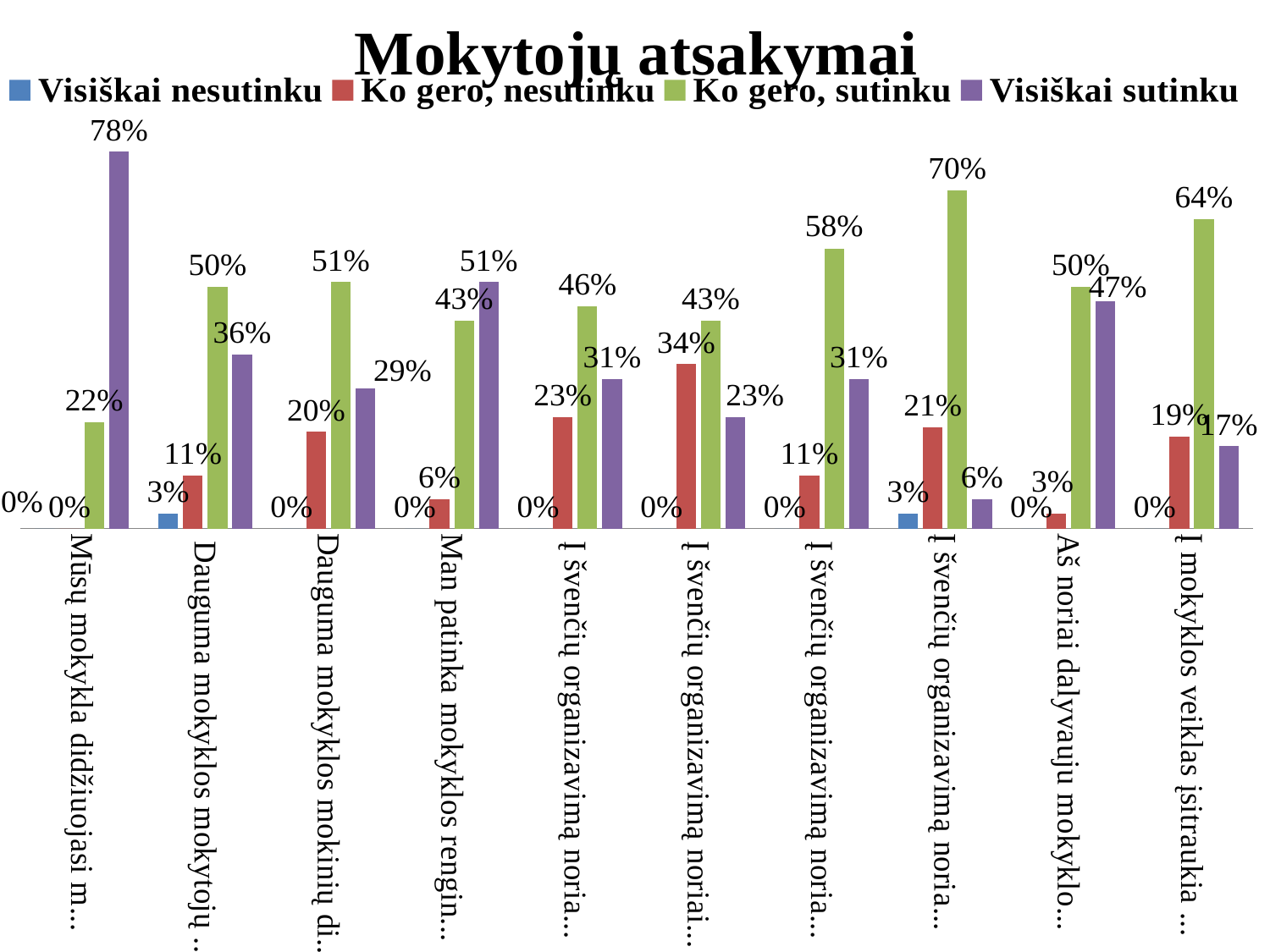
Which category has the highest 'Visiškai sutinku' value? Mūsų mokykla didžiuojasi m... What is the value of 'Ko gero, sutinku' for the category 'Į mokyklos veiklas įsitraukia ...'? 64% What is the title of the chart? Mokytojų atsakymai What is the value of 'Visiškai nesutinku' for the category 'Dauguma mokyklos mokytojų ...'? 3% How many series does the legend list? 4 What is the value of 'Ko gero, nesutinku' for the category 'Dauguma mokyklos mokinių di...'? 20% Which series is shown in green in the legend? Ko gero, sutinku What kind of chart is shown on the slide? bar chart How many categories are shown along the x axis? 10 For the category 'Man patinka mokyklos rengin...', which is larger: 'Ko gero, sutinku' or 'Visiškai sutinku'? Visiškai sutinku What is the difference between the 'Ko gero, sutinku' and 'Visiškai sutinku' values for the category 'Aš noriai dalyvauju mokyklo...'? 3% What is the value of 'Visiškai sutinku' for the category 'Mūsų mokykla didžiuojasi m...'? 78%